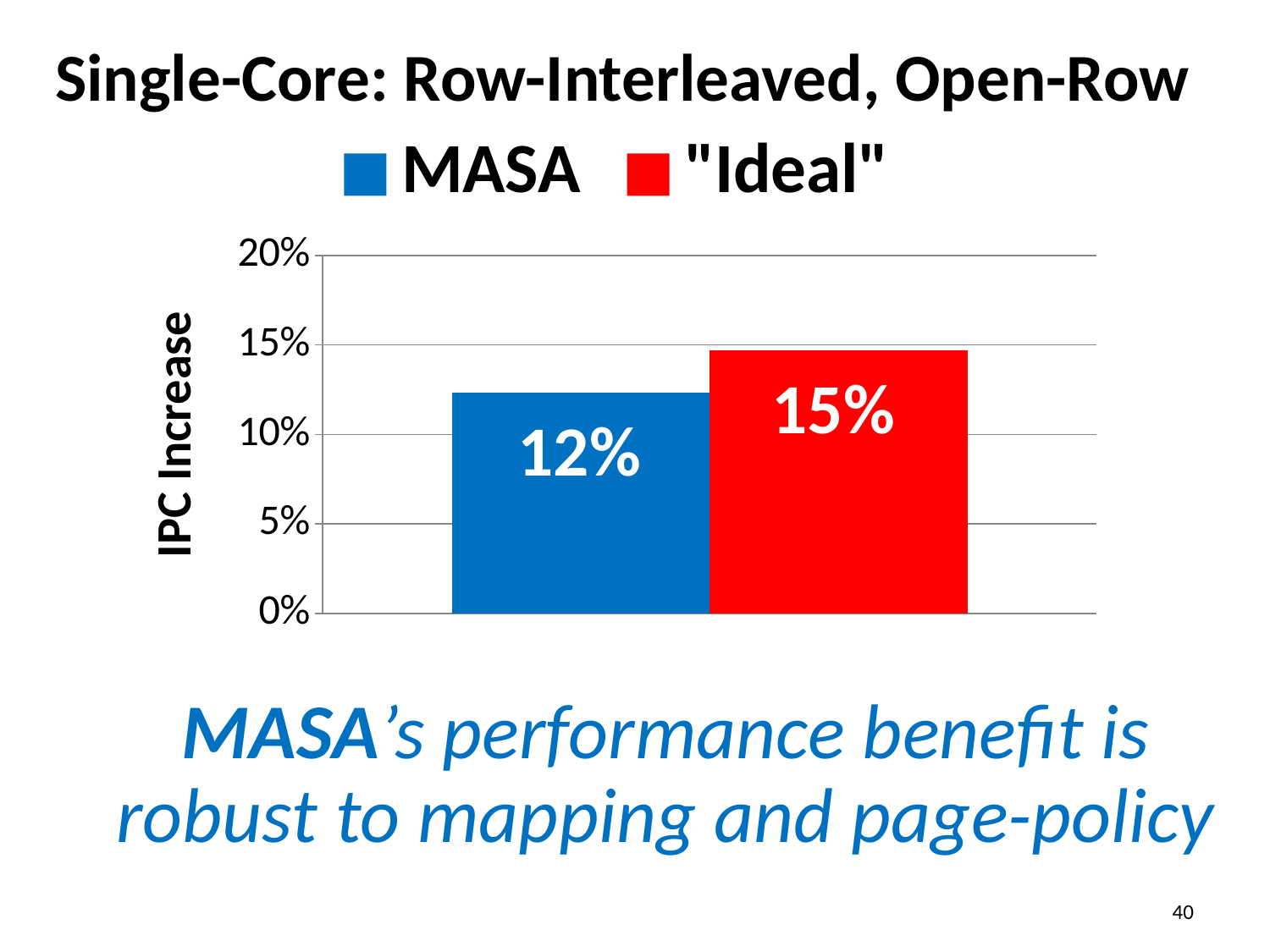
How many series does the legend list? 2 What colour is the bar for MASA? Blue Is the IPC increase for "Ideal" greater or less than 20%? less Which series shows the lowest IPC increase? MASA What is the label of the vertical axis? IPC Increase Which series shows the highest IPC increase? "Ideal" Is the IPC increase for MASA greater or less than 10%? greater What is the difference in IPC increase between "Ideal" and MASA? 2% What kind of chart is shown on the slide? Bar chart What is the IPC increase for "Ideal"? 15% Which series has the higher IPC increase, MASA or "Ideal"? "Ideal" What is the IPC increase for MASA? 12%